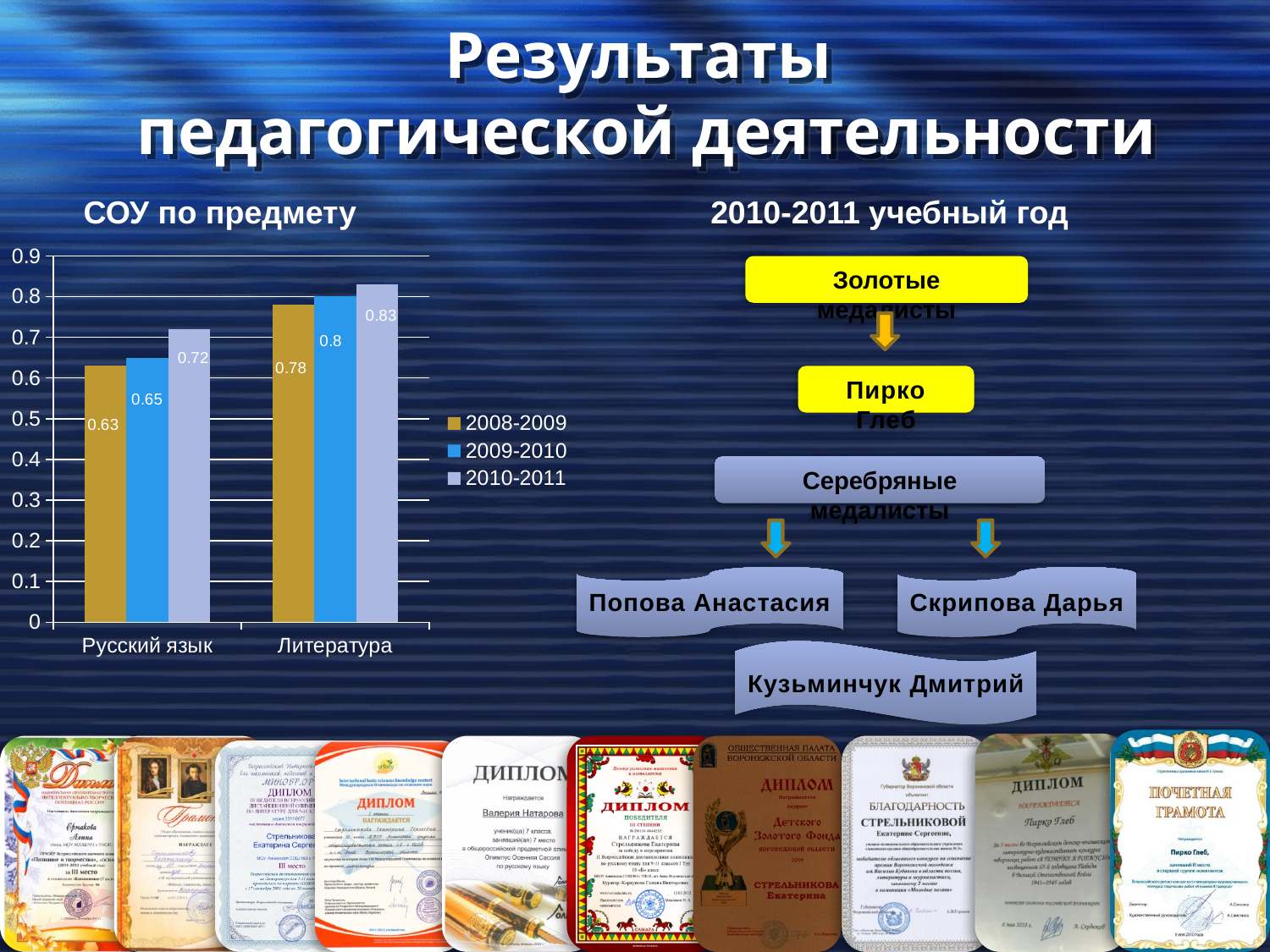
In the "СОУ по предмету" chart, what is the value for Литература in 2009-2010? 0.8 In the "СОУ по предмету" chart, which series has the lowest value for Русский язык? 2008-2009 In the "СОУ по предмету" chart, what is the value for Русский язык in 2008-2009? 0.63 In the "СОУ по предмету" chart, do the values for Литература rise or fall from 2008-2009 to 2010-2011? rise How many series does the legend of the "СОУ по предмету" chart list? 3 In the "СОУ по предмету" chart, what is the difference between the 2010-2011 and 2008-2009 values for Русский язык? 0.09 What type of chart is shown under the heading "СОУ по предмету"? bar chart In the "СОУ по предмету" chart, what is the value for Литература in 2010-2011? 0.83 In the "СОУ по предмету" chart, which is larger: the 2010-2011 value for Русский язык or the 2008-2009 value for Литература? 2008-2009 value for Литература How many categories are shown on the x axis of the "СОУ по предмету" chart? 2 In the "СОУ по предмету" chart, what is the value for Русский язык in 2009-2010? 0.65 In the "СОУ по предмету" chart, which category has the highest value in 2010-2011? Литература